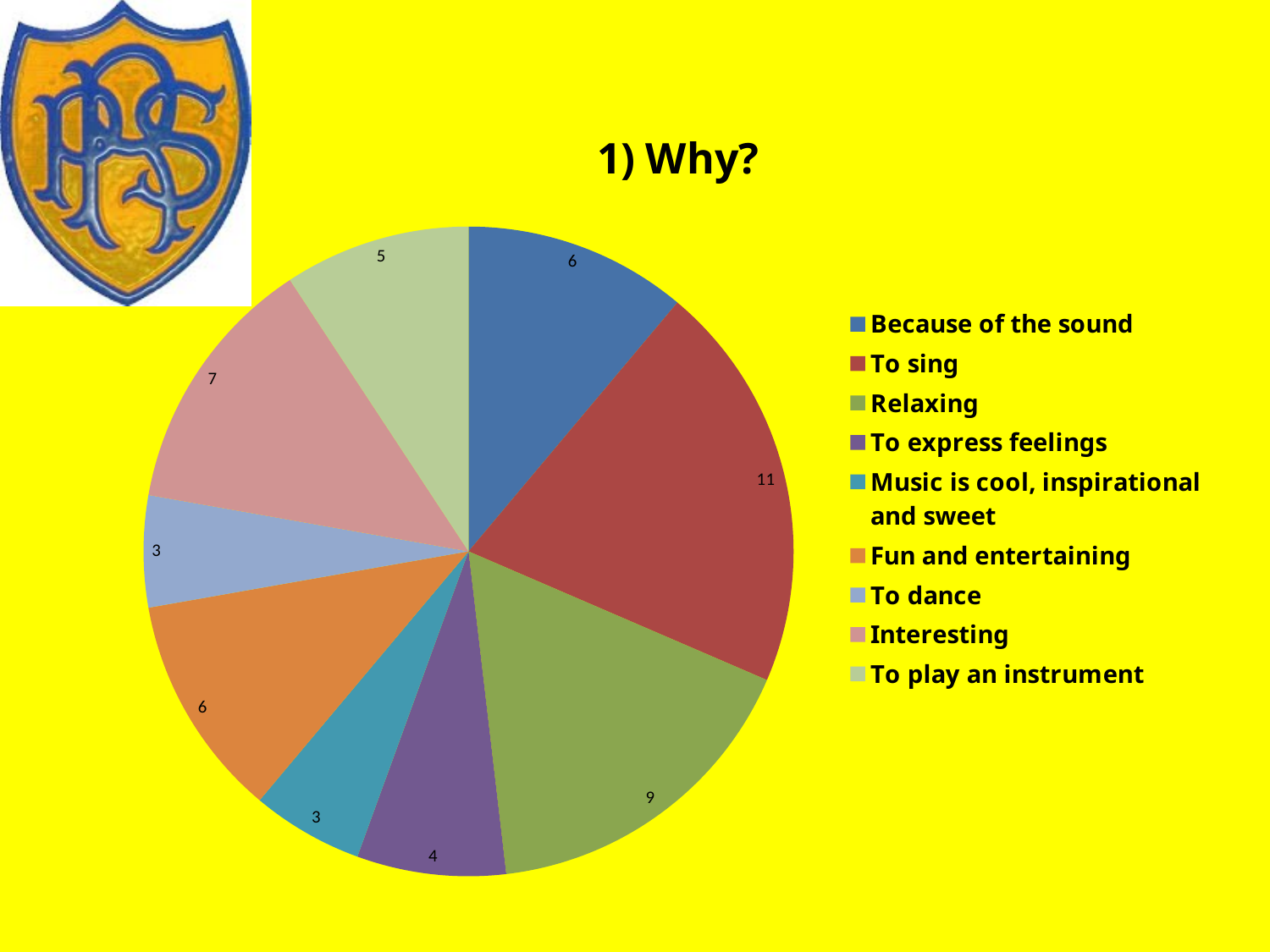
What is the value for "To sing"? 11 What is the value for "Relaxing"? 9 What type of chart is shown on the slide? pie chart Which is larger, the value for "Interesting" or the value for "Because of the sound"? Interesting What is the value for "To express feelings"? 4 Which category has the largest slice? To sing How many categories does the pie chart have? 9 What is the value for "To play an instrument"? 5 What is the difference between the values for "To sing" and "Relaxing"? 2 What is the value for "Interesting"? 7 What is the difference between the values for "Fun and entertaining" and "To dance"? 3 What is the title of the chart? 1) Why?